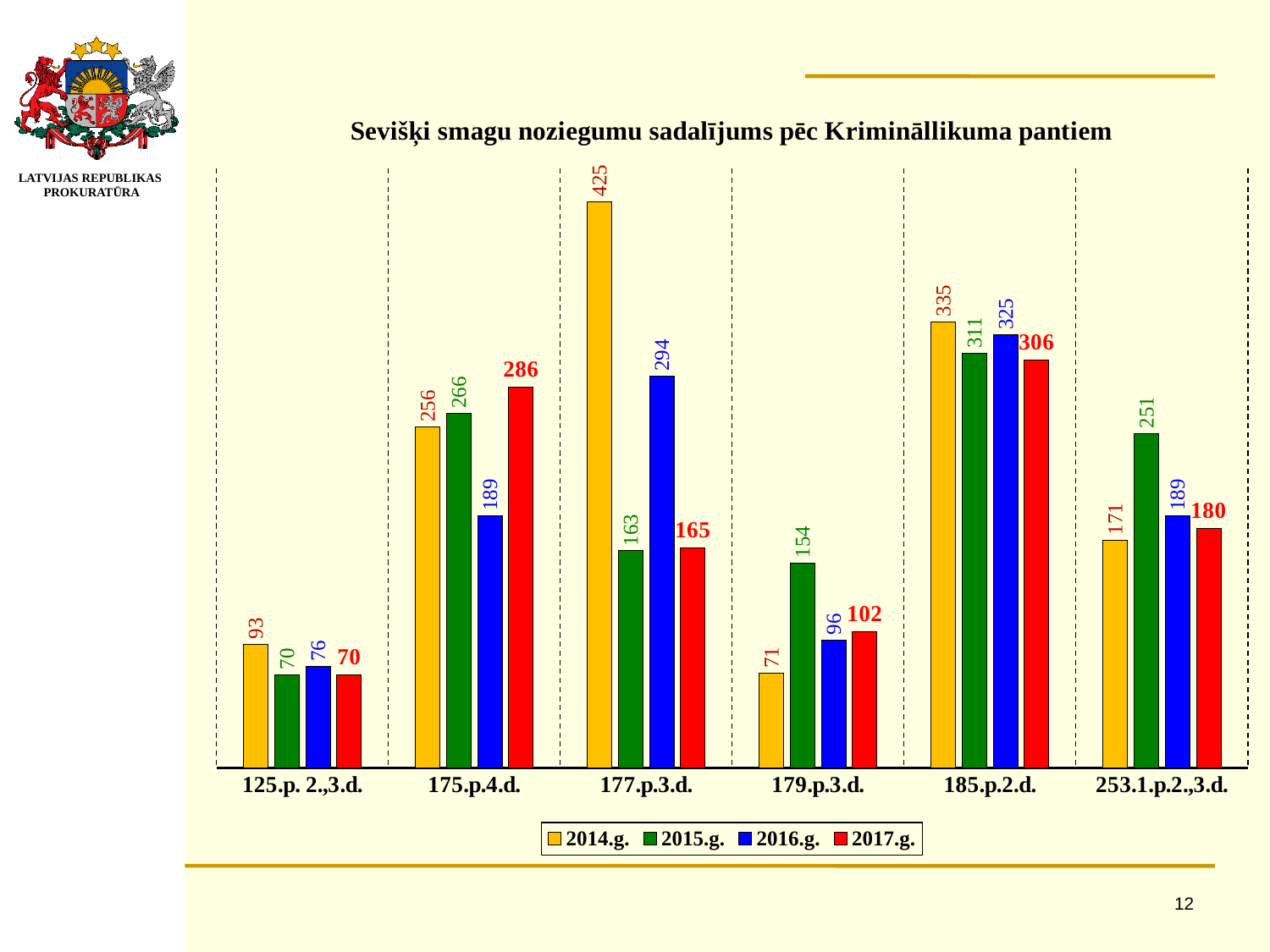
What kind of chart is shown on the slide? bar chart Which is larger for 175.p.4.d.: the 2017.g. value or the 2015.g. value? 2017.g. What is the difference between the 2014.g. and 2017.g. values for 177.p.3.d.? 260 How many categories are shown on the x axis? 6 How many series does the legend list? 4 What is the value for 253.1.p.2.,3.d. in the 2015.g. series? 251 What is the title of the chart? Sevišķi smagu noziegumu sadalījums pēc Krimināllikuma pantiem Which category has the lowest value in the 2017.g. series? 125.p. 2.,3.d. Which category has the highest value in the 2014.g. series? 177.p.3.d. What is the difference between the 2015.g. and 2014.g. values for 179.p.3.d.? 83 What is the value for 177.p.3.d. in the 2014.g. series? 425 What is the value for 185.p.2.d. in the 2017.g. series? 306